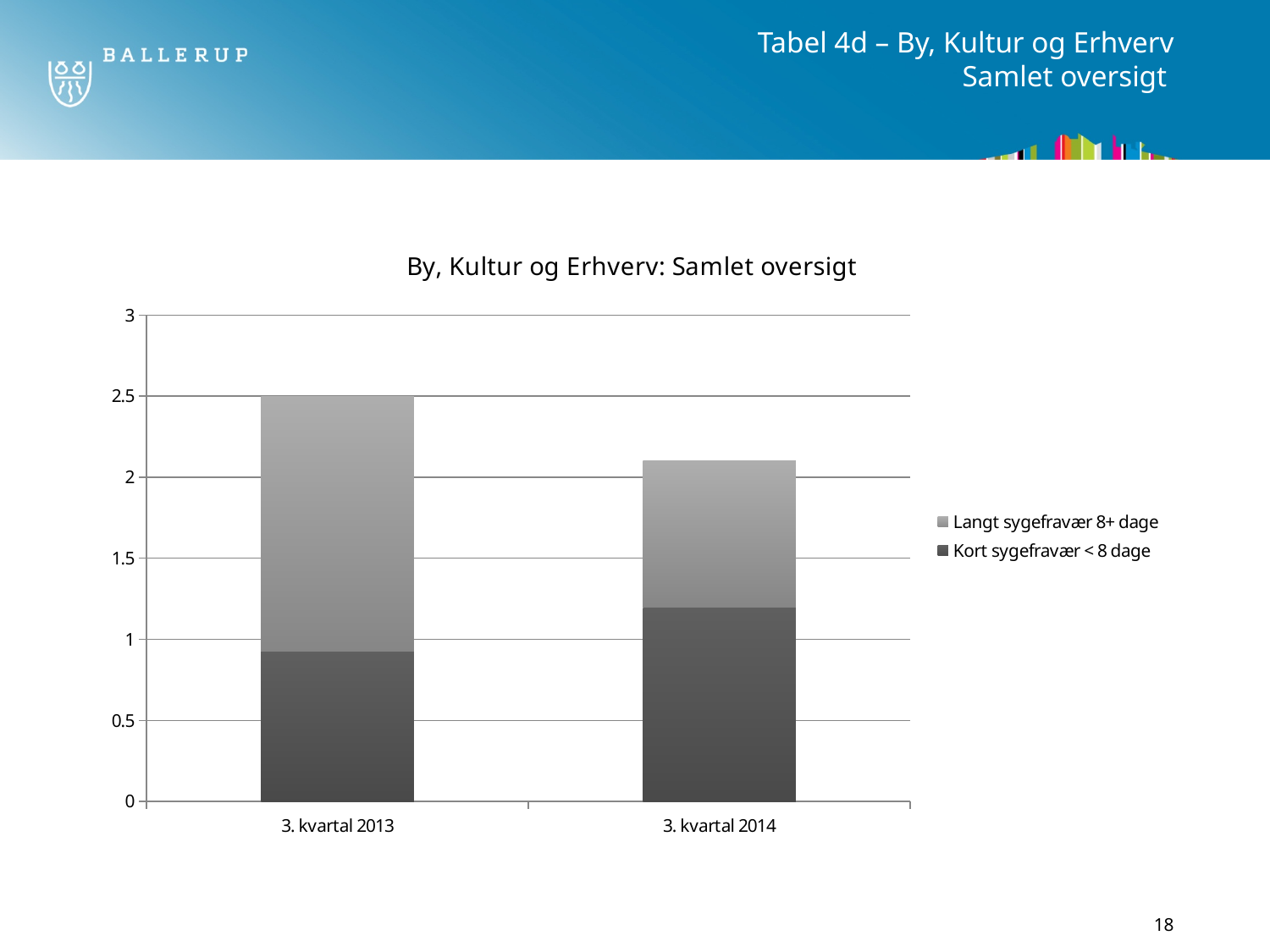
Does the total stacked value rise or fall from 3. kvartal 2013 to 3. kvartal 2014? fall Which series is shown in the darker colour at the bottom of each bar? Kort sygefravær < 8 dage How many series does the legend list? 2 Which quarter has the larger value for Kort sygefravær < 8 dage? 3. kvartal 2014 How many categories are shown on the x axis? 2 What kind of chart is shown on the slide? stacked bar chart Which quarter has the taller total stacked bar, 3. kvartal 2013 or 3. kvartal 2014? 3. kvartal 2013 Is the value for Langt sygefravær 8+ dage in 3. kvartal 2014 greater or less than 1? less Is the value for Kort sygefravær < 8 dage in 3. kvartal 2014 greater or less than 1? greater Is the total stacked value for 3. kvartal 2013 greater or less than 2? greater What is the title of the chart? By, Kultur og Erhverv: Samlet oversigt